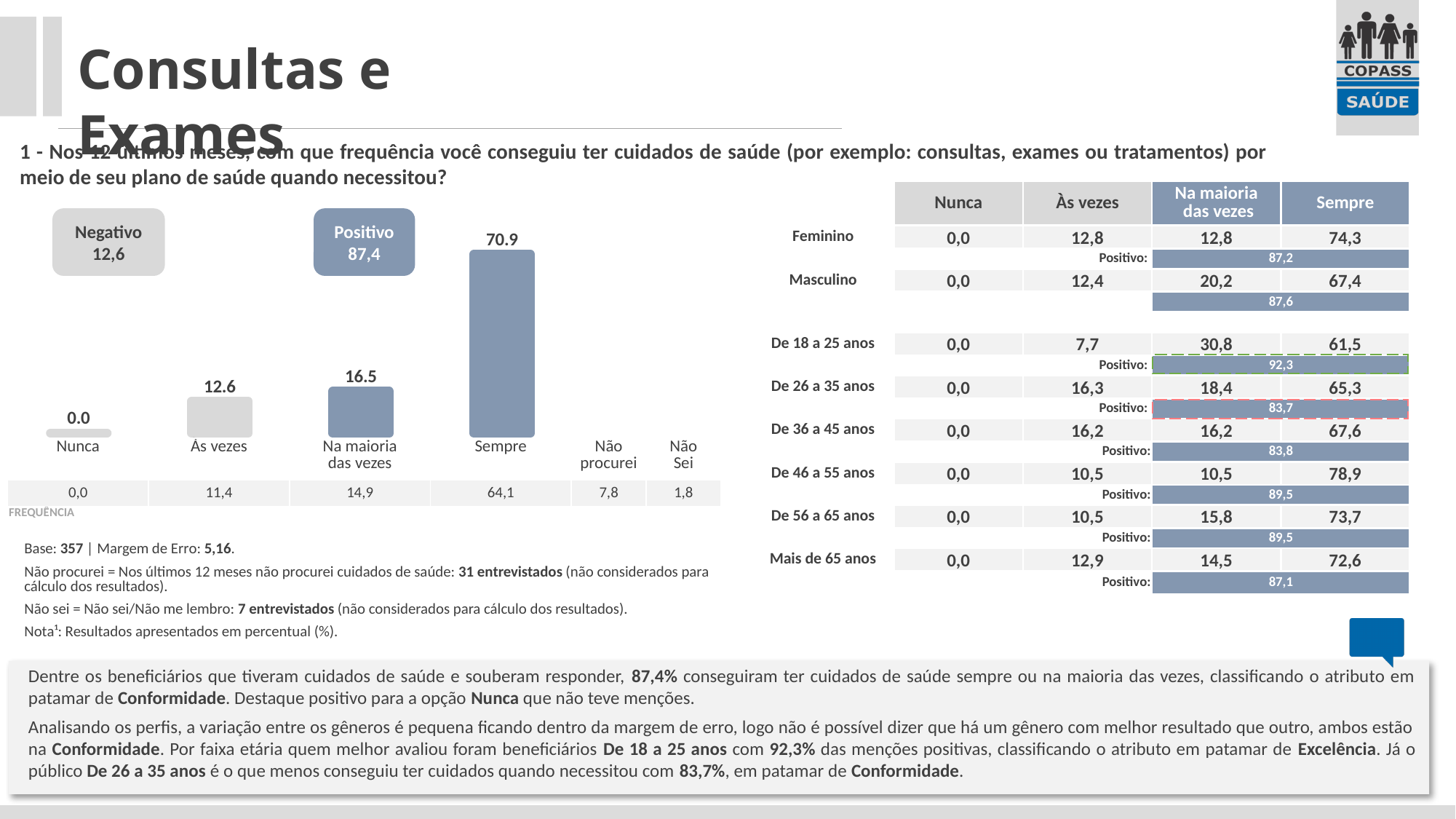
What is the value shown for Às vezes in the bar chart? 12.6 What is the difference between the values for Sempre and Na maioria das vezes in the bar chart? 54.4 Which category has the lowest value in the bar chart? Nunca Which is larger in the bar chart, the value for Às vezes or the value for Na maioria das vezes? Na maioria das vezes What is the value shown for Na maioria das vezes in the bar chart? 16.5 What value is shown in the Positivo box above the bar chart? 87,4 What kind of chart is shown on the left of the slide? Bar chart What is the value shown for Nunca in the bar chart? 0.0 What is the difference between the values for Sempre and Às vezes in the bar chart? 58.3 How many category labels appear along the x axis of the bar chart? 6 What is the value shown for Sempre in the bar chart? 70.9 Which category has the highest value in the bar chart? Sempre